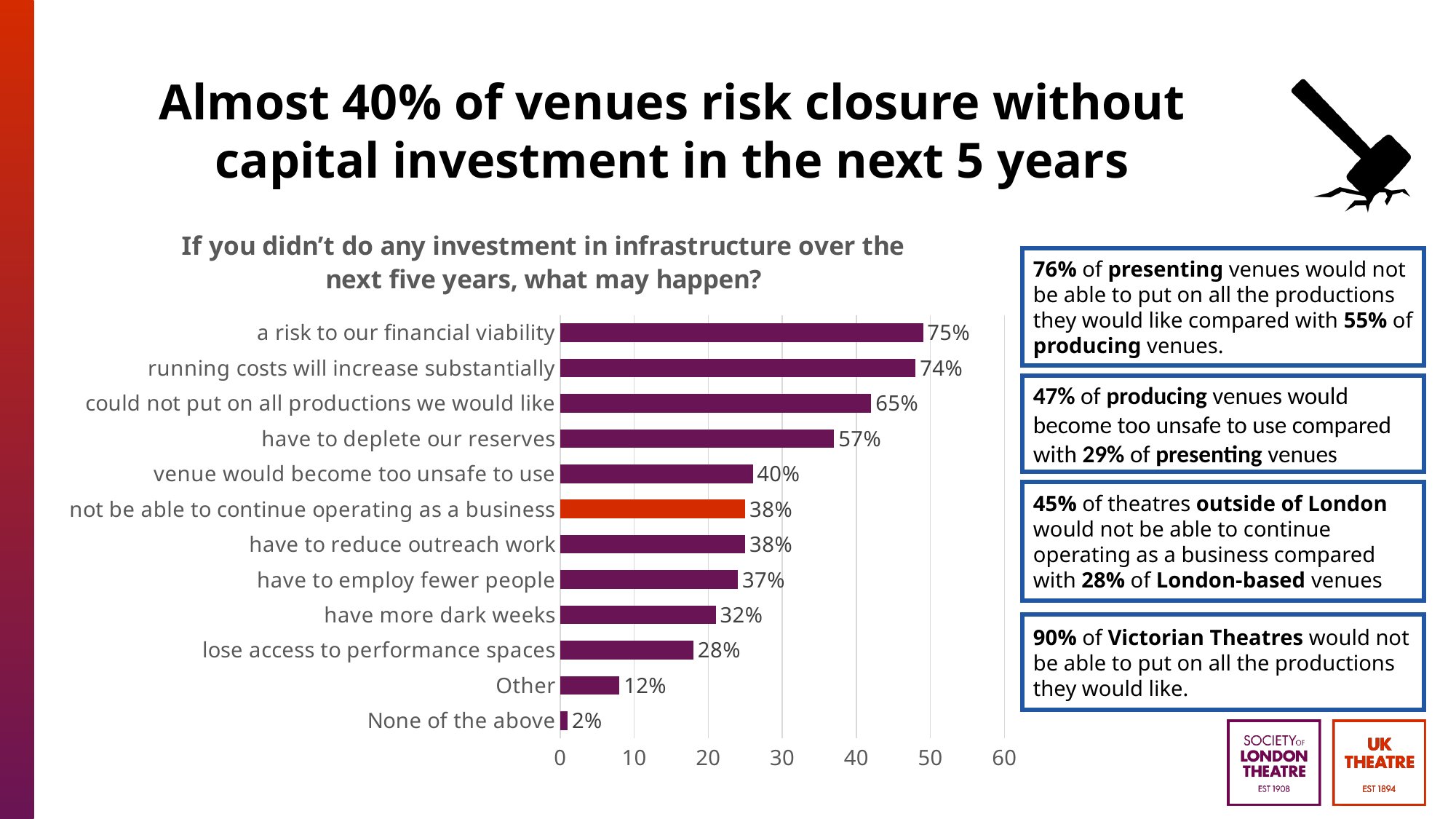
What value is shown for 'venue would become too unsafe to use'? 40% What is the difference between 'could not put on all productions we would like' and 'have to employ fewer people'? 28% Which is larger: 'have more dark weeks' or 'lose access to performance spaces'? have more dark weeks What is the value for 'Other'? 12% What is the difference between 'running costs will increase substantially' and 'have to deplete our reserves'? 17% What percentage of venues said there would be a risk to their financial viability? 75% What percentage is shown for 'not be able to continue operating as a business'? 38% What type of chart is shown on the slide? bar chart Which category has the lowest value in the chart? None of the above How many categories are shown in the chart? 12 Which category has the highest value in the chart? a risk to our financial viability Which bar is highlighted in a different colour (orange) from the rest? not be able to continue operating as a business